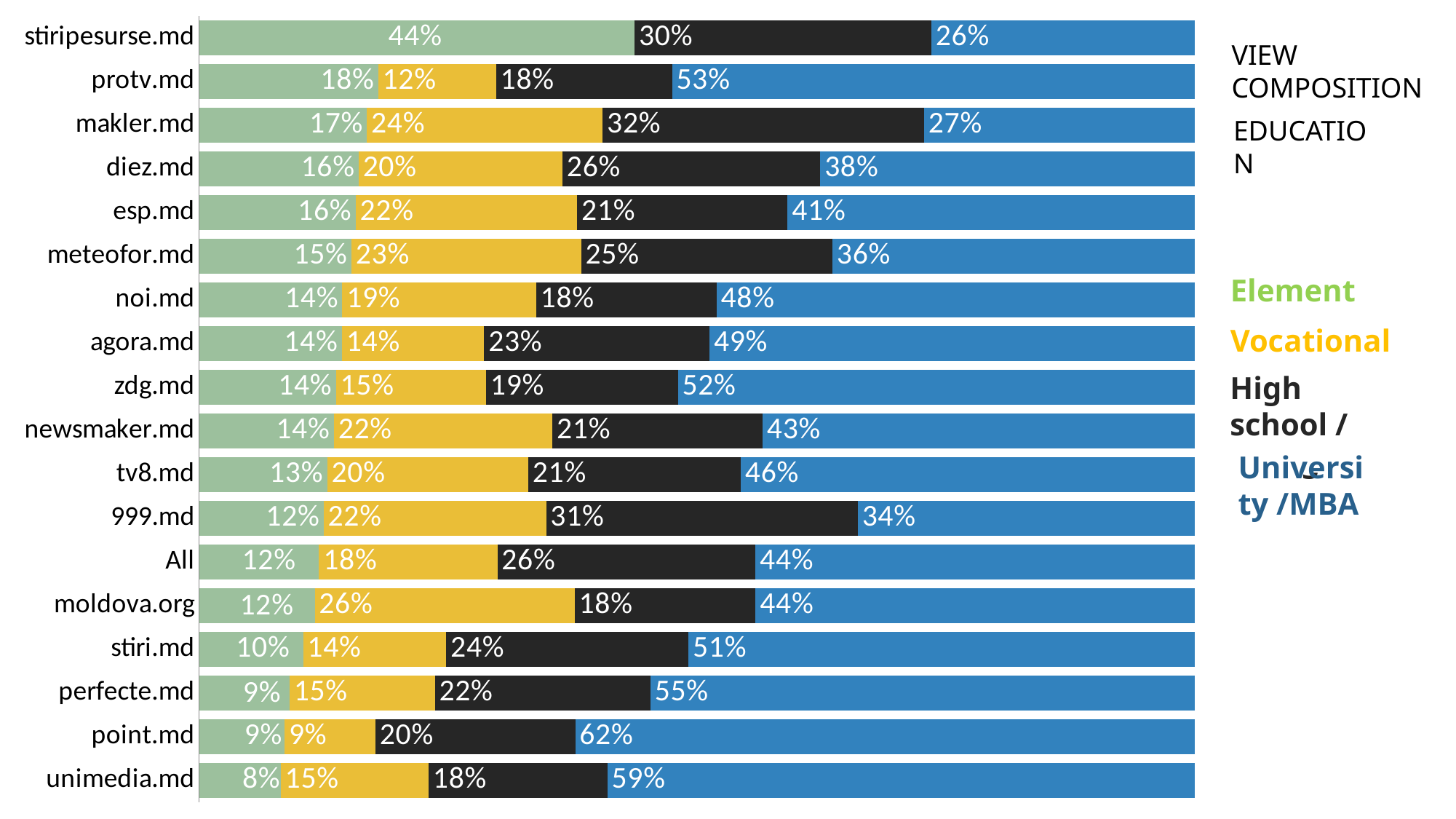
Which colour represents the Vocational education level in the chart? Yellow What is the difference between the University/MBA share of unimedia.md and that of stiripesurse.md? 33% What is the High school share for 999.md? 31% What is the Element share for stiripesurse.md? 44% What is the Vocational share for makler.md? 24% Which website has the highest University/MBA share? point.md Which has a larger High school share, makler.md or protv.md? makler.md How many websites (categories) are listed on the chart, including "All"? 18 Which website has the lowest Element share? unimedia.md What is the University/MBA share for point.md? 62% What kind of chart is shown on the slide? Stacked bar chart How many education levels does the legend list? 4